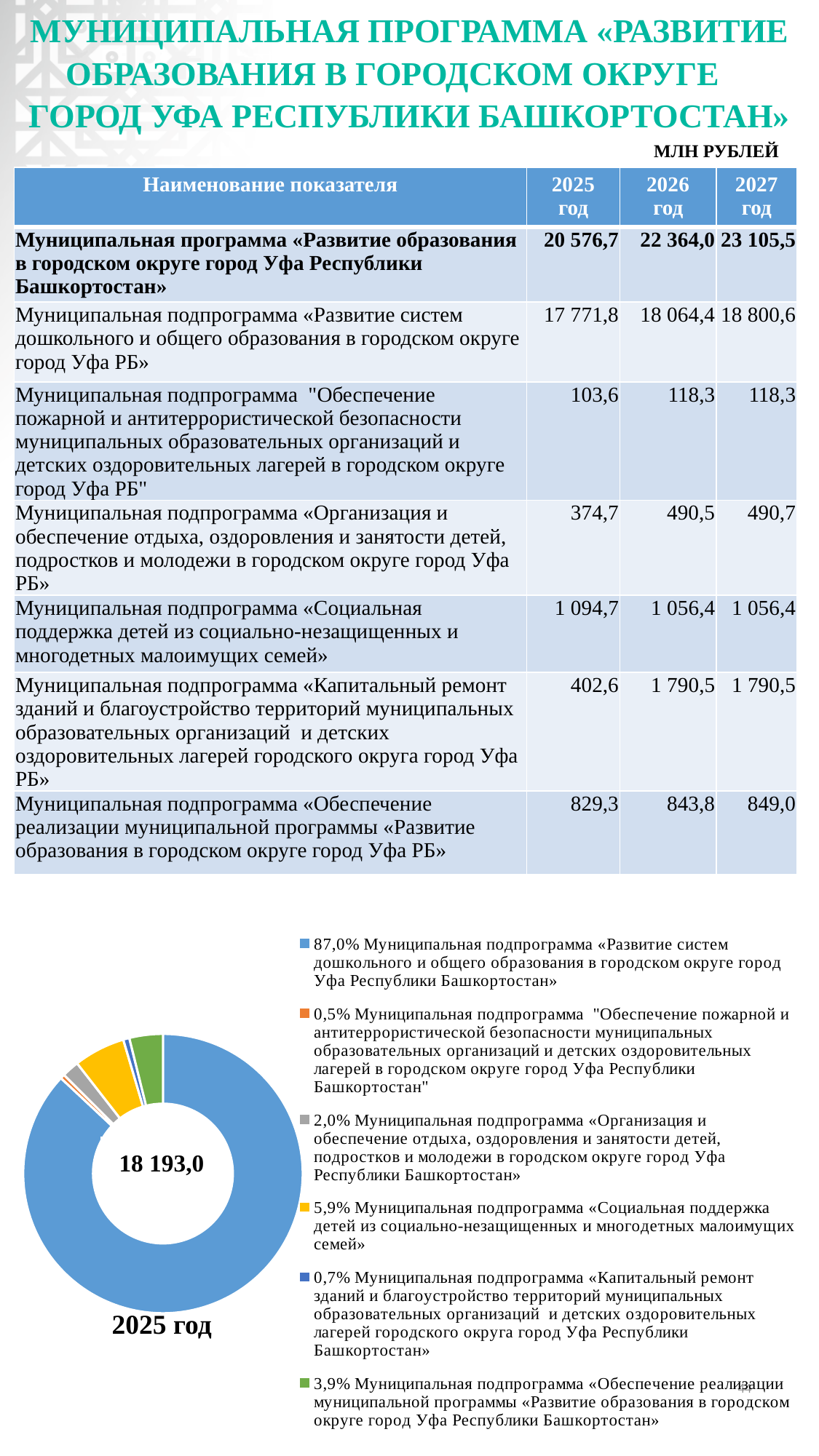
Which subprogram has the largest slice in the doughnut chart? Муниципальная подпрограмма «Развитие систем дошкольного и общего образования в городском округе город Уфа Республики Башкортостан» In the doughnut chart, what is the difference in share between «Социальная поддержка детей» (5,9%) and «Обеспечение реализации муниципальной программы» (3,9%)? 2,0% In the doughnut chart, which has the larger share: «Социальная поддержка детей» or «Обеспечение реализации муниципальной программы»? «Социальная поддержка детей» What value is printed in the centre of the doughnut chart? 18 193,0 How many slices does the doughnut chart have? 6 What share of the doughnut chart does the subprogram «Организация и обеспечение отдыха, оздоровления и занятости детей» have? 2,0% What kind of chart is shown at the bottom of the slide? Pie chart (doughnut) Which year does the doughnut chart represent, according to the label beneath it? 2025 год What share of the doughnut chart does the subprogram «Обеспечение реализации муниципальной программы» have? 3,9% What share of the doughnut chart does the subprogram «Социальная поддержка детей из социально-незащищенных и многодетных малоимущих семей» have? 5,9%